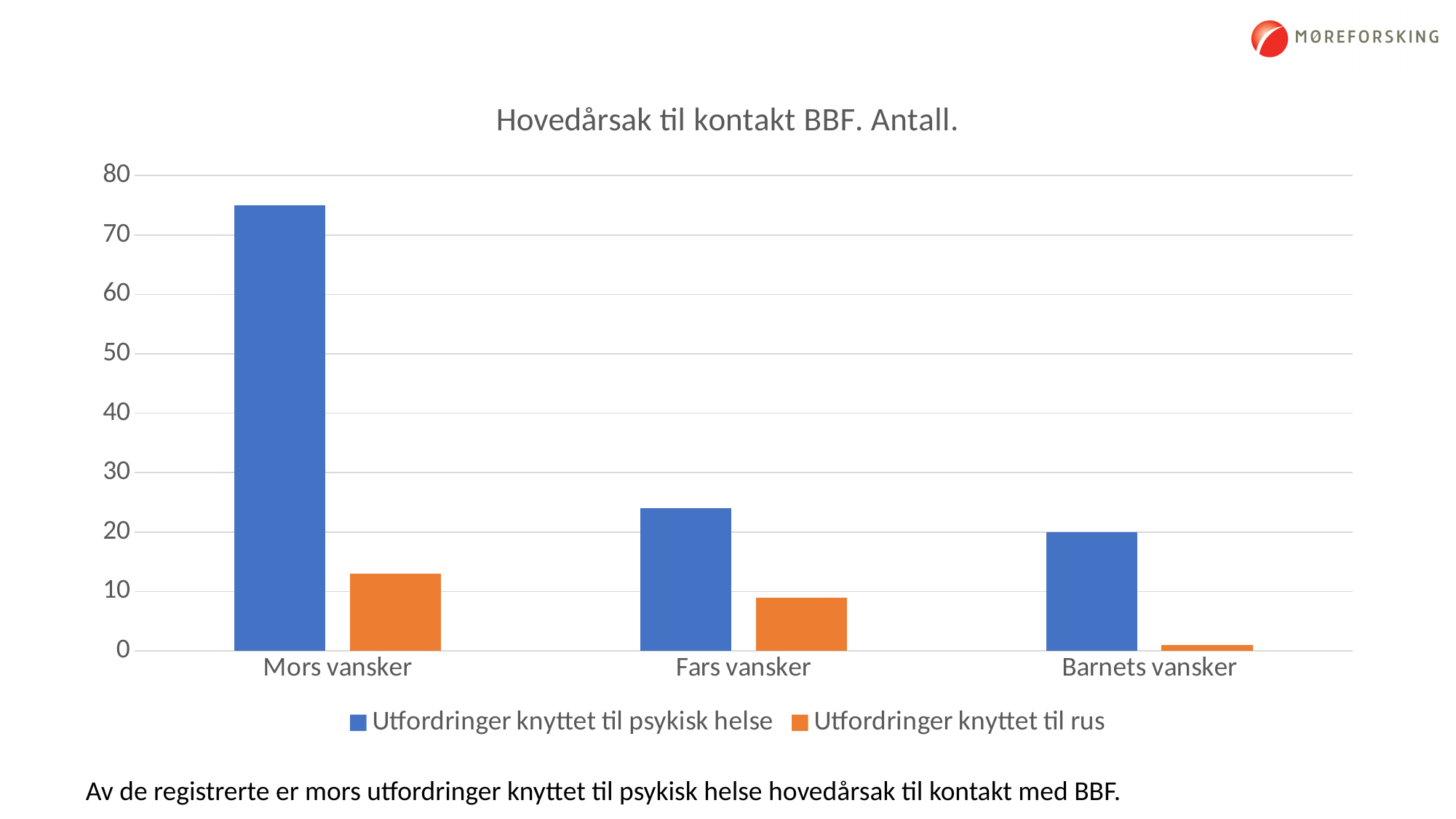
Is the value for Utfordringer knyttet til psykisk helse for Fars vansker greater or less than 30? less Do the values for Utfordringer knyttet til rus rise or fall from Mors vansker to Barnets vansker? fall Which category has the highest value for Utfordringer knyttet til psykisk helse? Mors vansker How many series does the legend list? 2 Which category has the lowest value for Utfordringer knyttet til rus? Barnets vansker Which colour represents Utfordringer knyttet til rus in the chart? orange Which is larger for Mors vansker: Utfordringer knyttet til psykisk helse or Utfordringer knyttet til rus? Utfordringer knyttet til psykisk helse Is the value for Utfordringer knyttet til psykisk helse for Mors vansker greater or less than 70? greater How many categories are shown on the x axis? 3 What is the title of the chart? Hovedårsak til kontakt BBF. Antall. What kind of chart is shown on the slide? bar chart Is the value for Utfordringer knyttet til rus for Fars vansker greater or less than 10? less